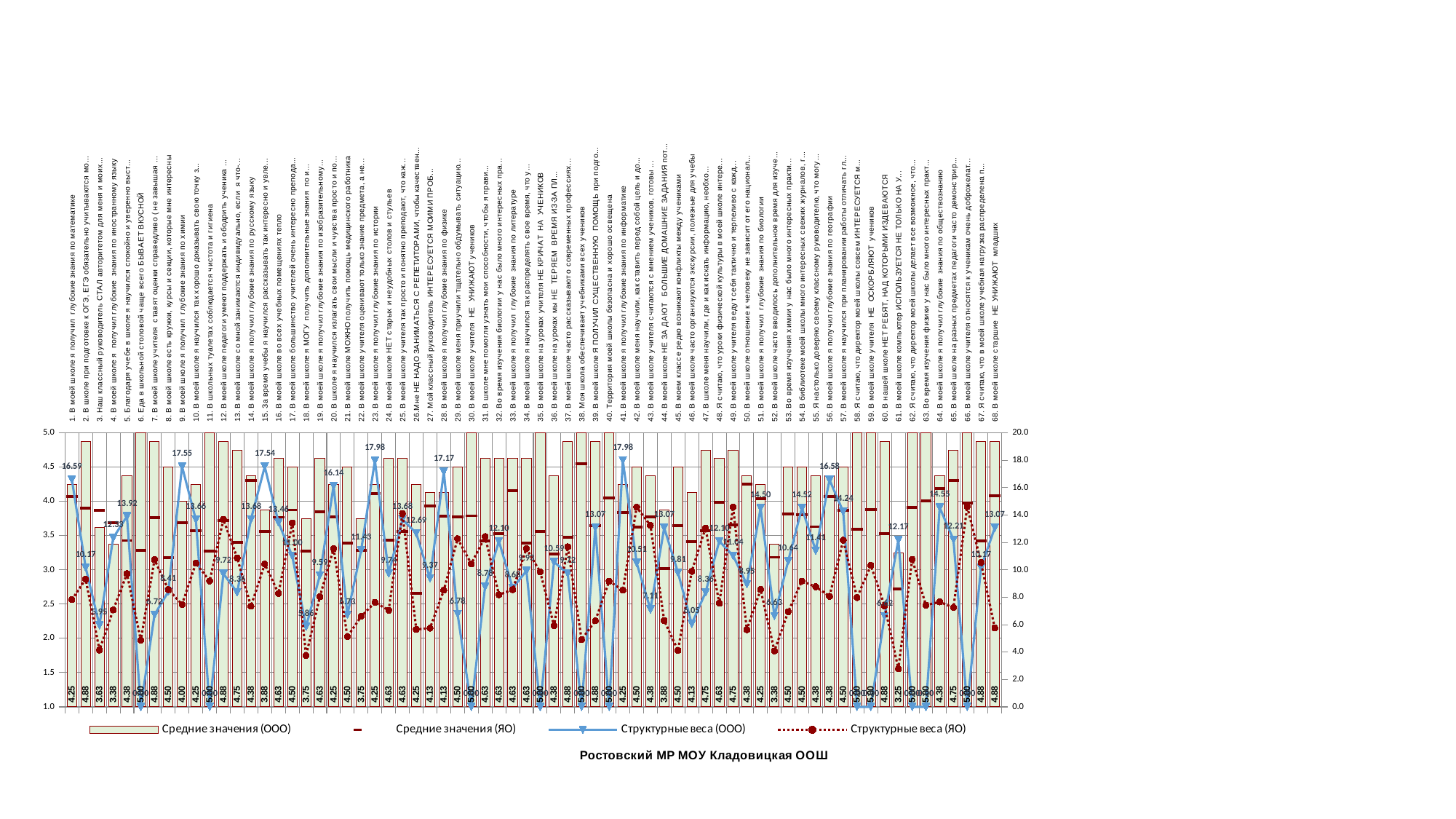
What is the value of Средние значения (ООО) for statement 1 (глубокие знания по математике)? 4.25 Which statement has the lowest Средние значения (ООО) bar? 61. В моей школе компьютер ИСПОЛЬЗУЕТСЯ НЕ ТОЛЬКО НА У... (3.25) What is the chart's title? Ростовский МР МОУ Кладовицкая ООШ What kind of chart is this? Combination bar and line chart What is the value of Средние значения (ООО) for statement 33 (глубокие знания по литературе)? 4.63 How many series does the legend list? 4 How many categories (statements) are plotted along the x axis? 68 Which is larger, the Средние значения (ООО) for statement 14 (русский язык) or for statement 28 (физика)? Statement 14 (русский язык), 4.38 What is the difference between the Средние значения (ООО) for statement 33 (литература) and statement 9 (химия)? 0.63 What is the value of Средние значения (ООО) for statement 28 (глубокие знания по физике)? 4.13 What is the value of Средние значения (ООО) for statement 9 (глубокие знания по химии)? 4.00 What is the Структурные веса (ООО) value for statement 1 (глубокие знания по математике)? 16.59